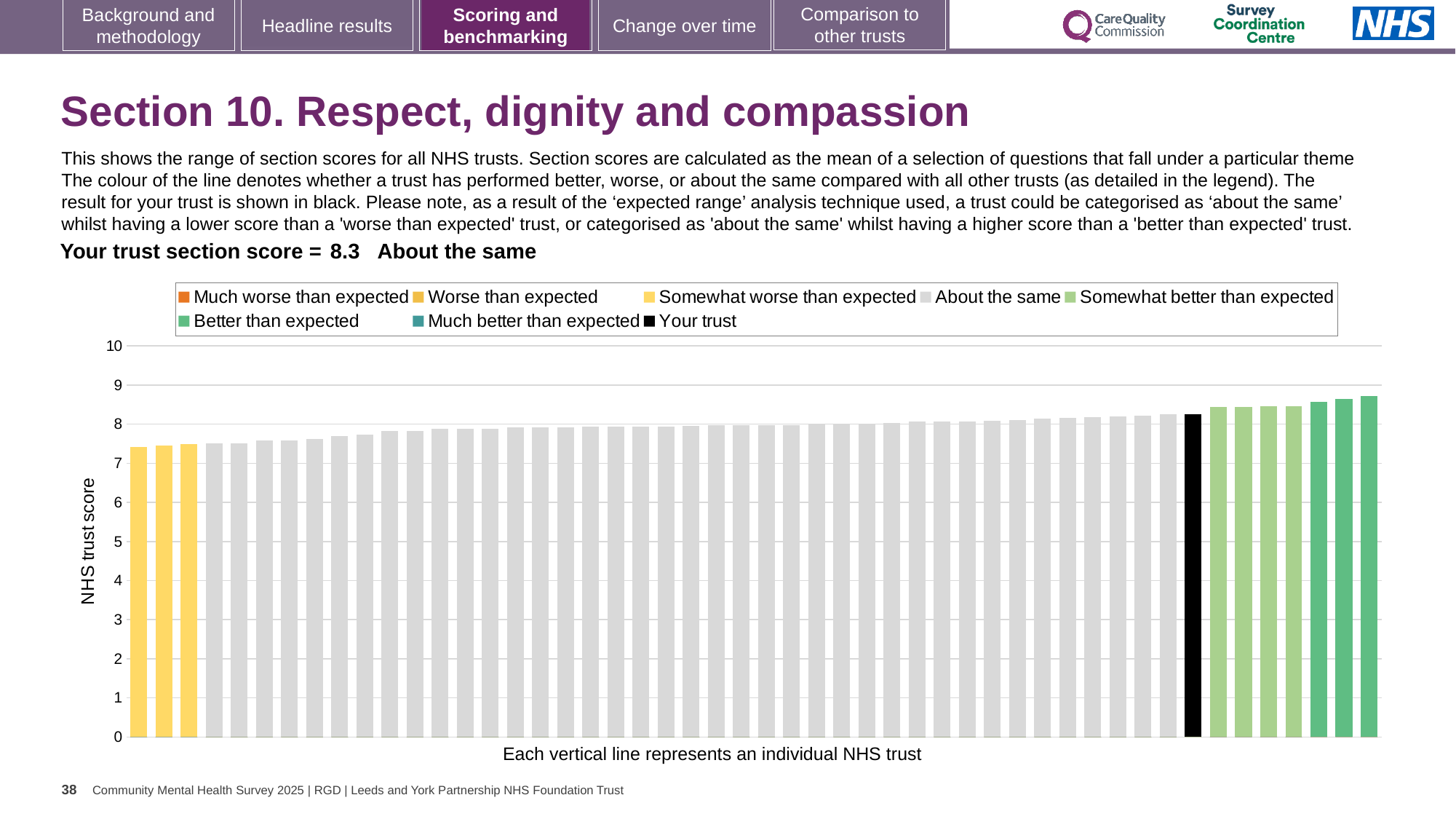
How many entries does the chart legend list? 8 Do the bar values rise or fall from left to right along the x axis? rise Is the value of the rightmost (highest) bar greater or less than 9? less What kind of chart is shown on the slide? Bar chart What is the title of the vertical axis? NHS trust score How many yellow bars are there at the left of the chart? 3 What is the section score for your trust shown on the slide? 8.3 How many dark green 'Better than expected' bars are there at the right of the chart? 3 Is the value of the black 'Your trust' bar greater or less than 8? greater Which is larger, the black 'Your trust' bar or the leftmost yellow bar? The black 'Your trust' bar Which category is your trust placed in for this section? About the same Is the value of the leftmost (lowest) bar greater or less than 7? greater